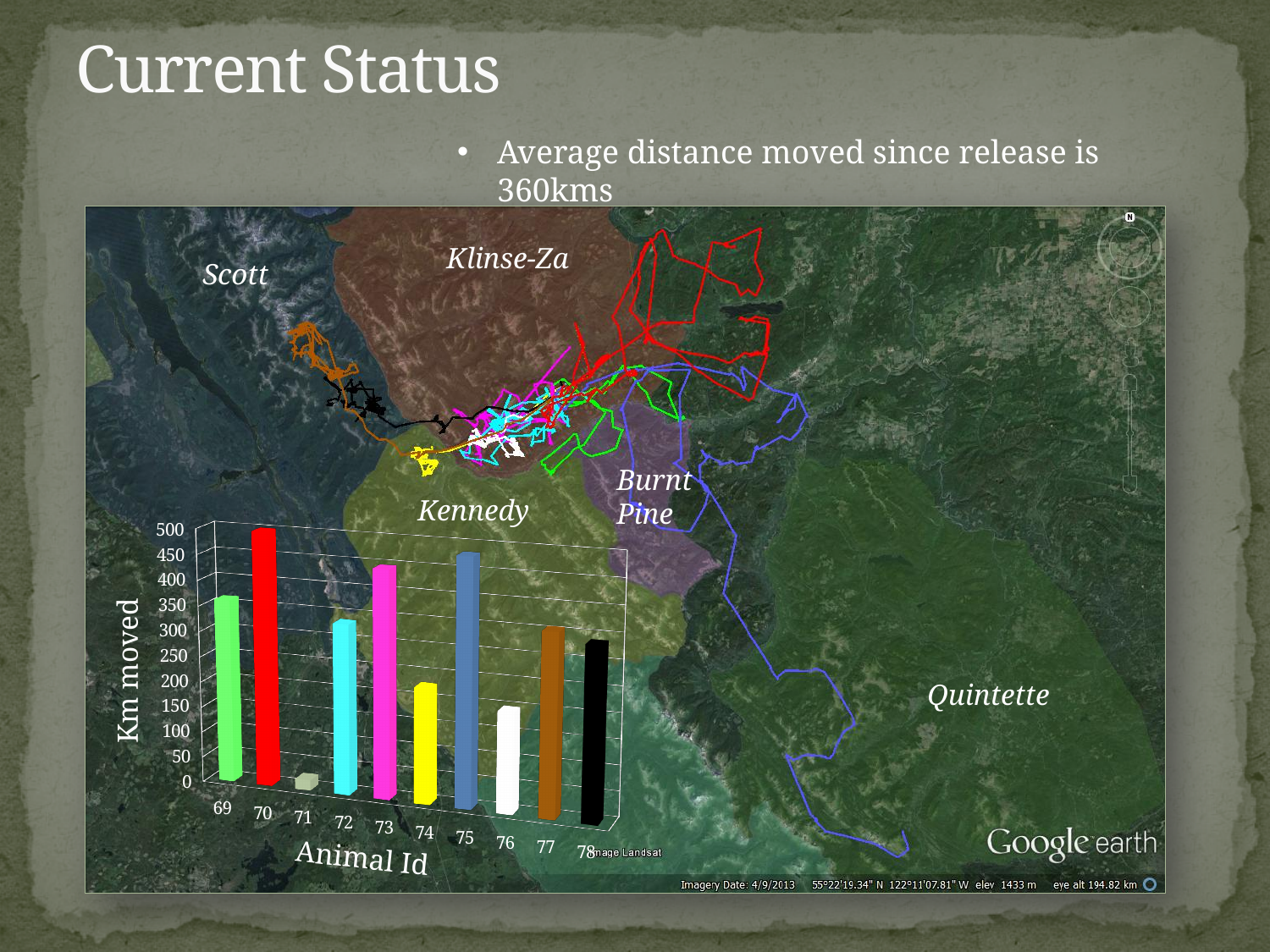
Which has a larger Km moved value, animal 73 or animal 74? 73 What is the label on the horizontal axis of the chart? Animal Id How many animal IDs are shown on the x axis of the chart? 10 What is the label on the vertical axis of the chart? Km moved Is the Km moved for animal 70 greater or less than 450? greater Which has a larger Km moved value, animal 75 or animal 76? 75 What kind of chart is shown on the slide? bar chart Which animal ID has the highest Km moved in the chart? 70 Is the Km moved for animal 75 greater or less than 400? greater Is the Km moved for animal 76 greater or less than 250? less Which animal ID has the lowest Km moved in the chart? 71